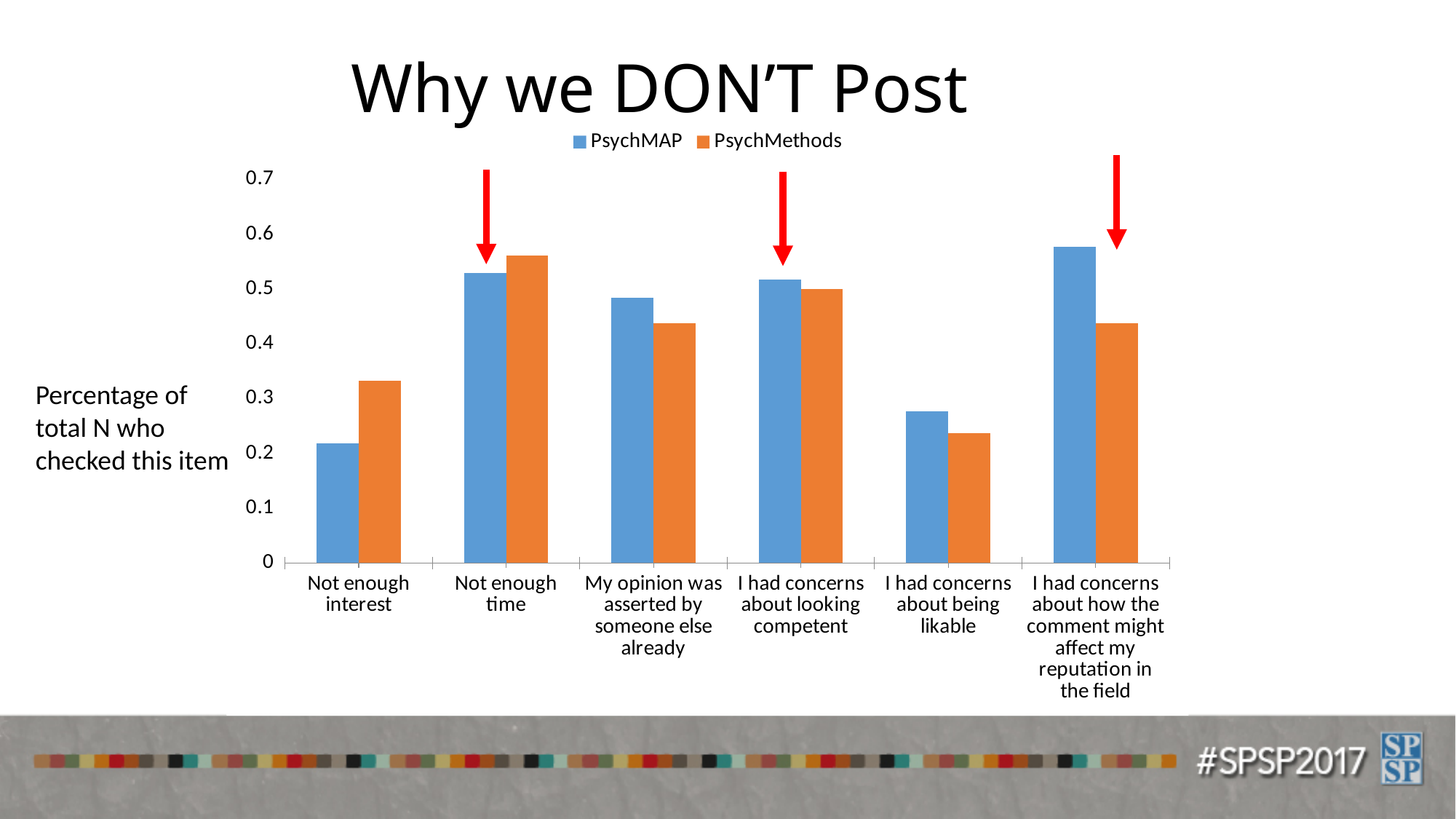
How many series does the legend list? 2 Is the PsychMethods value for "Not enough time" greater or less than 0.5? greater Is the PsychMAP value for "I had concerns about how the comment might affect my reputation in the field" greater or less than 0.5? greater For "Not enough interest", which series has the larger value, PsychMAP or PsychMethods? PsychMethods Which category has the lowest PsychMethods value? I had concerns about being likable Which category has the highest PsychMethods value? Not enough time Which category has the highest PsychMAP value? I had concerns about how the comment might affect my reputation in the field Which category has the lowest PsychMAP value? Not enough interest What kind of chart is shown on the slide? bar chart Is the PsychMAP value for "Not enough interest" greater or less than 0.3? less How many categories are shown on the x axis? 6 What is the title of the chart? Why we DON'T Post